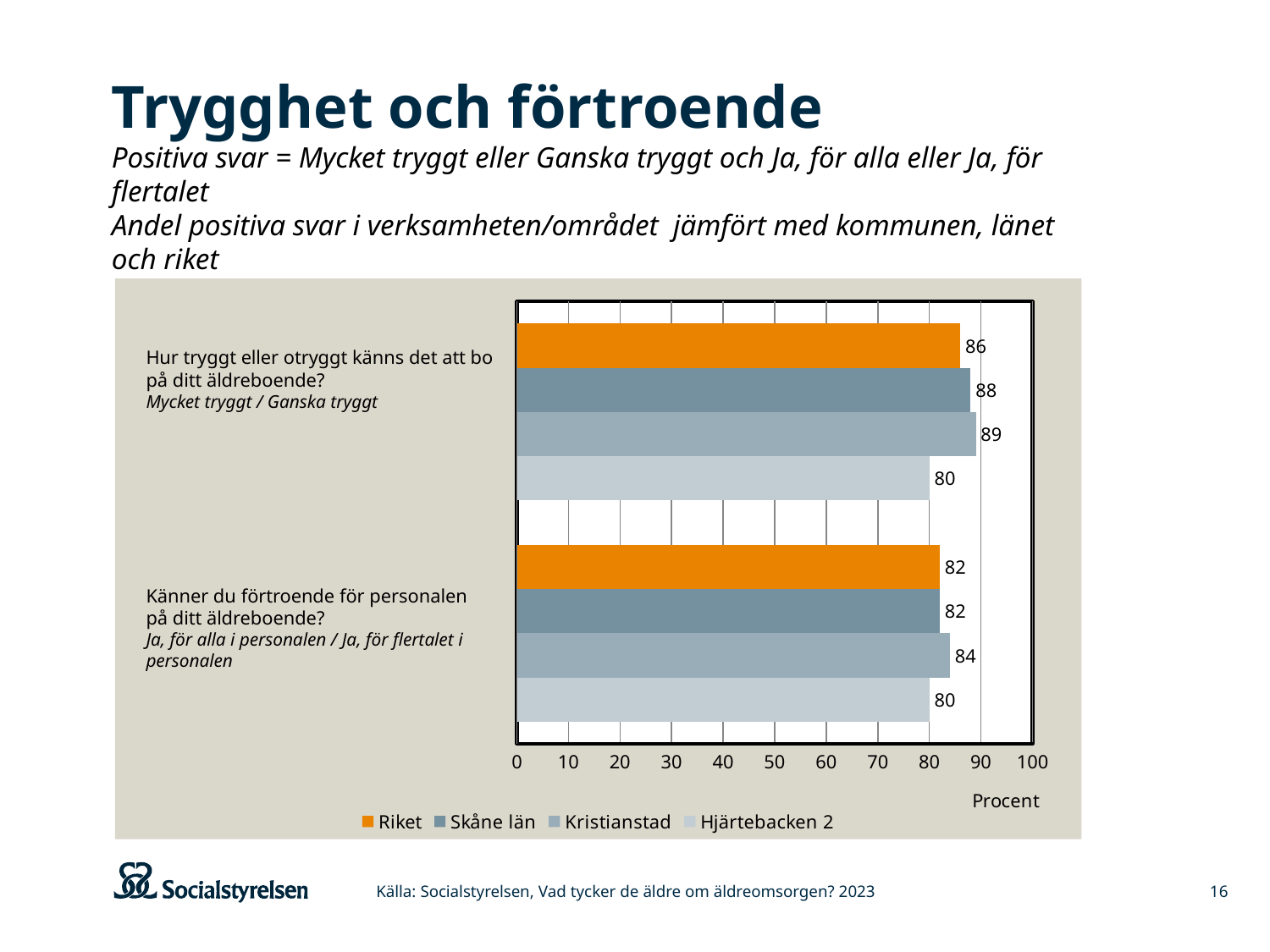
What is the value for Riket on the question "Hur tryggt eller otryggt känns det att bo på ditt äldreboende?"? 86 What kind of chart is shown on the slide? bar chart Which series is shown in orange in the legend? Riket What is the value for Hjärtebacken 2 on the question "Känner du förtroende för personalen på ditt äldreboende?"? 80 Which series has the lowest value on the question "Känner du förtroende för personalen på ditt äldreboende?"? Hjärtebacken 2 Which is larger on the question "Känner du förtroende för personalen på ditt äldreboende?": the value for Kristianstad or the value for Hjärtebacken 2? Kristianstad What is the value for Skåne län on the question "Känner du förtroende för personalen på ditt äldreboende?"? 82 What is the value for Kristianstad on the question "Hur tryggt eller otryggt känns det att bo på ditt äldreboende?"? 89 What is the label on the horizontal axis of the chart? Procent How many series does the legend list? 4 Which series has the highest value on the question "Hur tryggt eller otryggt känns det att bo på ditt äldreboende?"? Kristianstad What is the difference between the Kristianstad and Hjärtebacken 2 values on the question "Hur tryggt eller otryggt känns det att bo på ditt äldreboende?"? 9